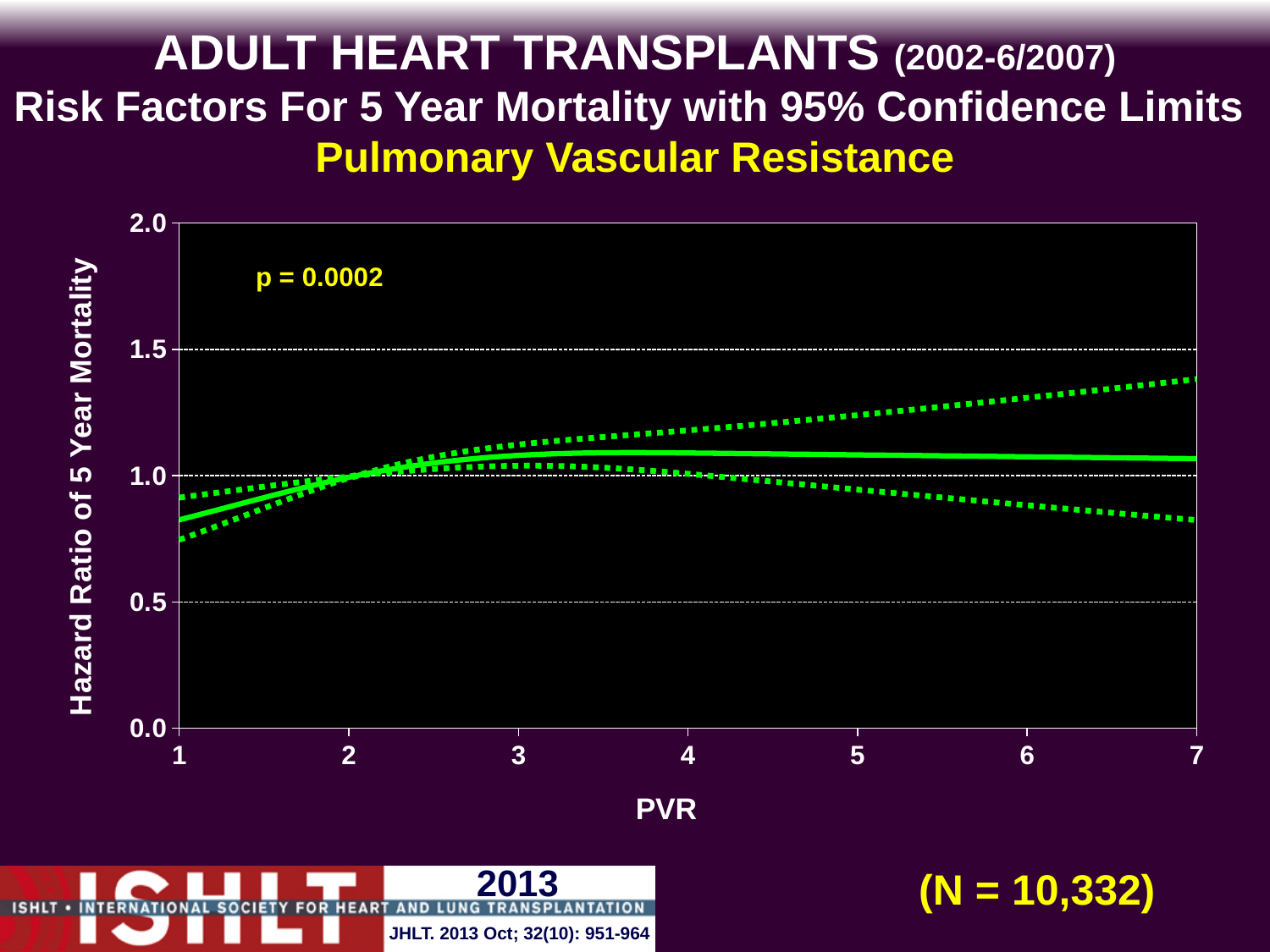
How many lines are plotted on the chart? 3 Is the lower 95% confidence limit at PVR 7 greater or less than 1.0? less What sample size (N) is shown on the slide? N = 10,332 Is the hazard ratio (solid line) at PVR 4 greater or less than 1.0? greater Does the hazard ratio (solid line) rise or fall as PVR increases from 1 to 3? rises How many tick values are labelled on the PVR (x) axis? 7 What kind of chart is shown on the slide? line chart Is the upper 95% confidence limit at PVR 7 greater or less than 1.5? less What is the p-value printed on the chart? p = 0.0002 Which is larger, the hazard ratio at PVR 1 or the hazard ratio at PVR 4? PVR 4